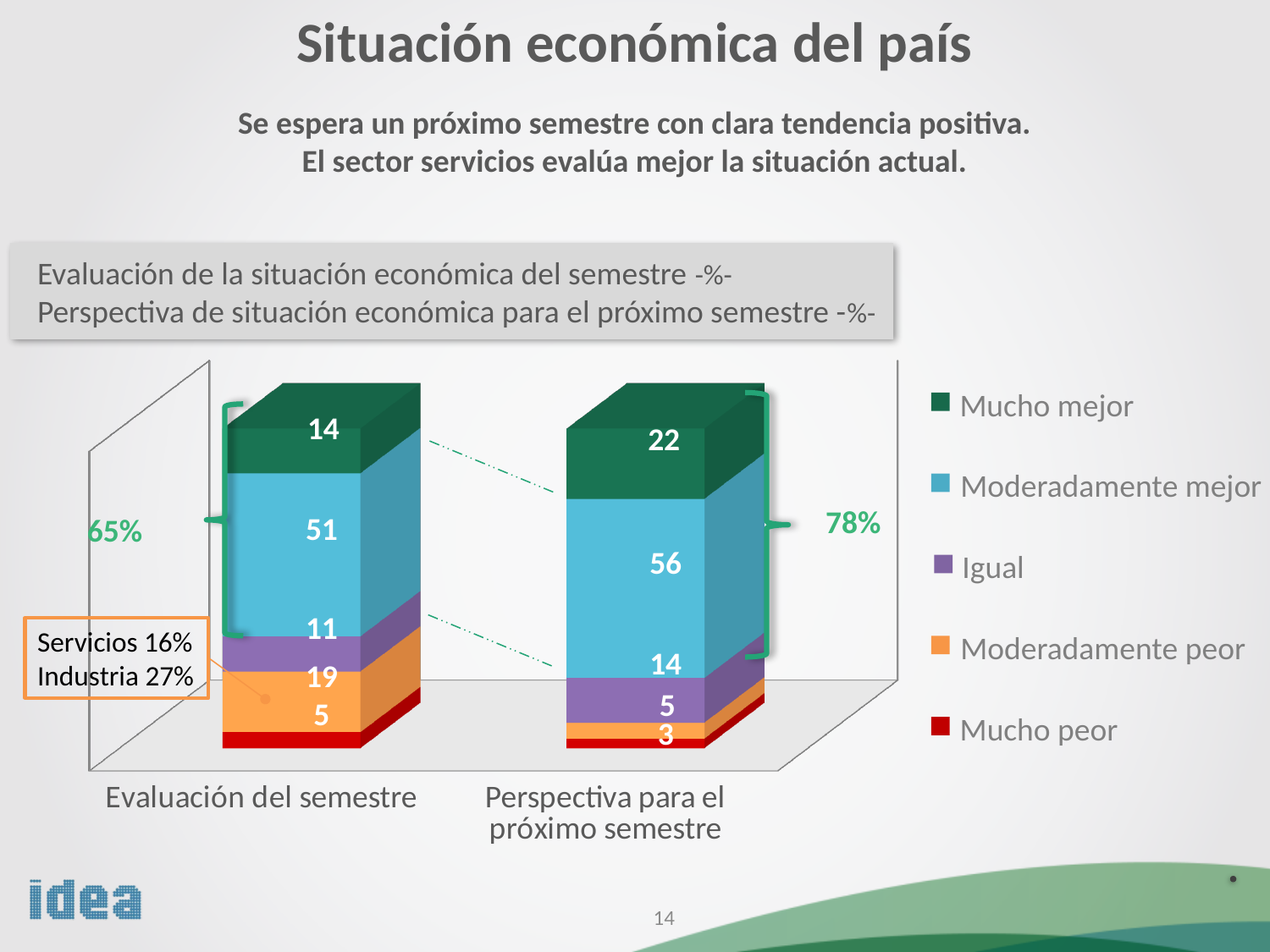
Which category has the larger 'Mucho mejor' value, 'Evaluación del semestre' or 'Perspectiva para el próximo semestre'? Perspectiva para el próximo semestre How many series does the legend list? 5 What is the total of the stacked bar for 'Evaluación del semestre'? 100 What is the value of 'Moderadamente mejor' for 'Evaluación del semestre'? 51 What percentage is shown next to the bracket for 'Perspectiva para el próximo semestre'? 78% What is the value of 'Igual' for 'Perspectiva para el próximo semestre'? 14 What kind of chart is shown on the slide? stacked bar chart How many categories are shown on the x axis? 2 Which legend entry is shown in red? Mucho peor What is the value of 'Moderadamente peor' for 'Evaluación del semestre'? 19 What is the value of 'Mucho mejor' for 'Perspectiva para el próximo semestre'? 22 What is the difference between the 'Moderadamente mejor' values for 'Perspectiva para el próximo semestre' and 'Evaluación del semestre'? 5